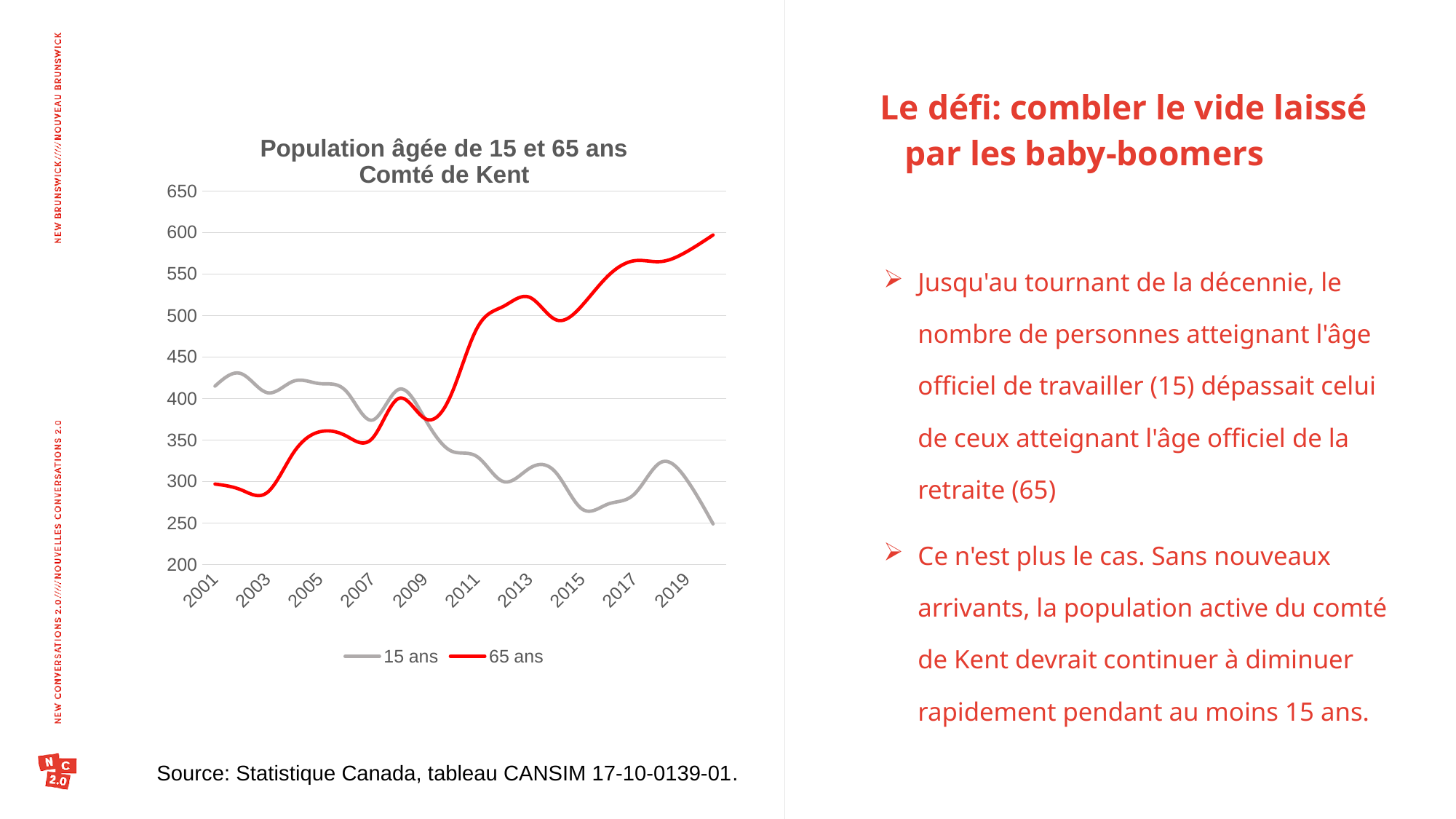
In 2001, which series has the larger value, 15 ans or 65 ans? 15 ans Is the value for 65 ans in 2019 greater or less than 550? greater What is the title of the chart? Population âgée de 15 et 65 ans Comté de Kent How many year labels are shown on the x axis? 10 What are the two series named in the legend? 15 ans and 65 ans Does the 65 ans line generally rise or fall from 2001 to 2019? rise Is the value for 15 ans in 2015 greater or less than 300? less Does the 15 ans line generally rise or fall from 2001 to 2019? fall How many series does the legend list? 2 In 2019, which series has the larger value, 15 ans or 65 ans? 65 ans Is the value for 65 ans in 2013 greater or less than 500? greater What kind of chart is shown on the slide? line chart